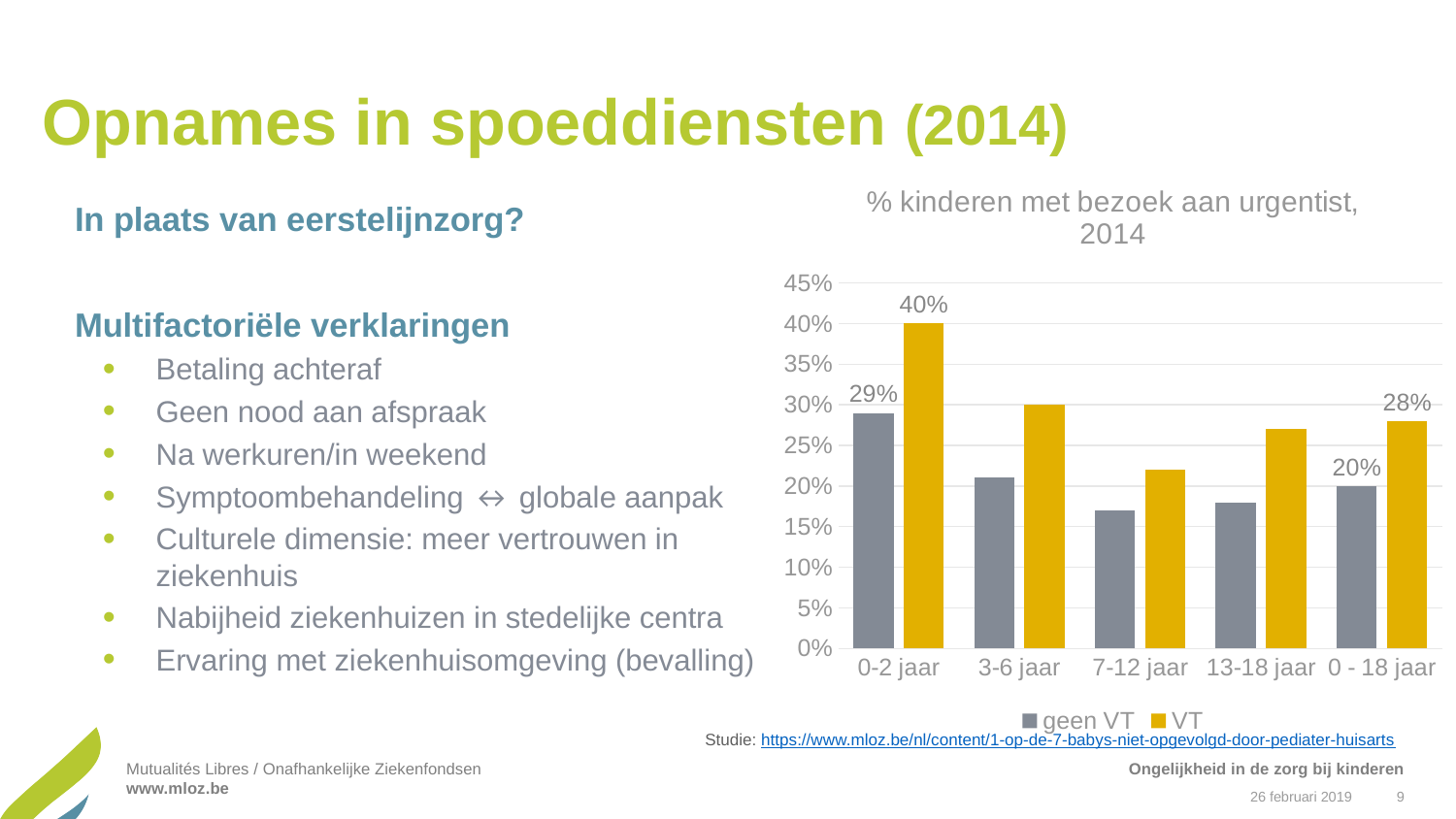
What is the difference between the VT and geen VT values for 0 - 18 jaar? 8% What is the value for VT in the 0-2 jaar category? 40% What is the value for VT in the 0 - 18 jaar category? 28% Which age category has the lowest VT value? 7-12 jaar How many series does the legend list? 2 Which bar is the highest in the chart? VT for 0-2 jaar What is the difference between the VT and geen VT values for 0-2 jaar? 11% For 3-6 jaar, which is larger: geen VT or VT? VT What is the value for geen VT in the 0 - 18 jaar category? 20% Is the geen VT value for 7-12 jaar greater or less than 20%? less How many age categories are shown on the x axis? 5 What is the value for geen VT in the 0-2 jaar category? 29%